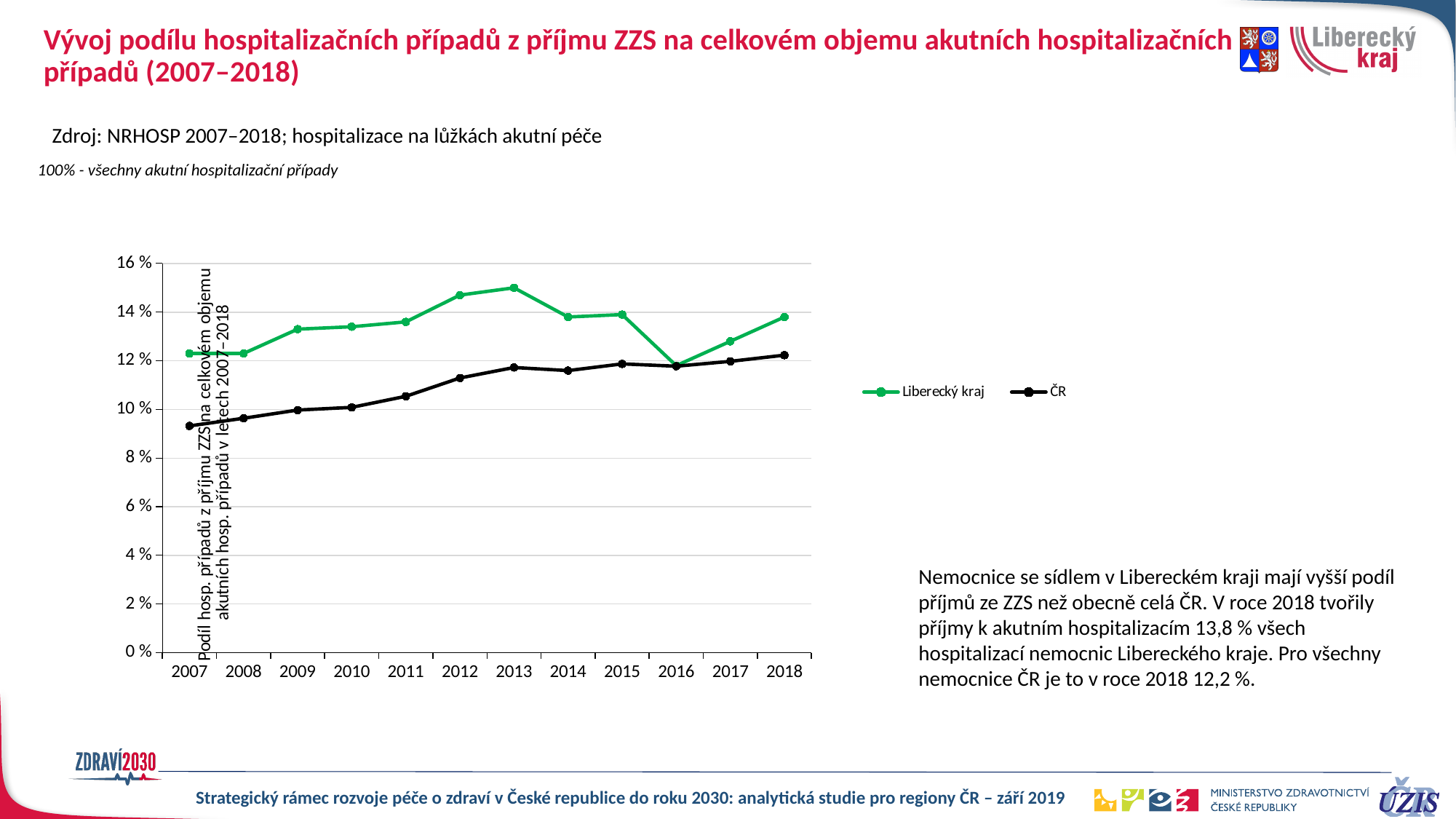
Is the value for ČR in 2013 greater or less than 12 %? less How many years are plotted along the x axis? 12 What kind of chart is shown on the slide? line chart In which year does the Liberecký kraj series reach its highest value? 2013 Is the value for ČR in 2007 greater or less than 10 %? less Which series is shown in green in the legend? Liberecký kraj Is the value for Liberecký kraj in 2013 greater or less than 14 %? greater In 2013, which series has the larger value, Liberecký kraj or ČR? Liberecký kraj Does the ČR series generally rise or fall from 2007 to 2018? rise In which year is the ČR series at its lowest value? 2007 How many series does the legend list? 2 In which year is the Liberecký kraj series at its lowest value? 2016